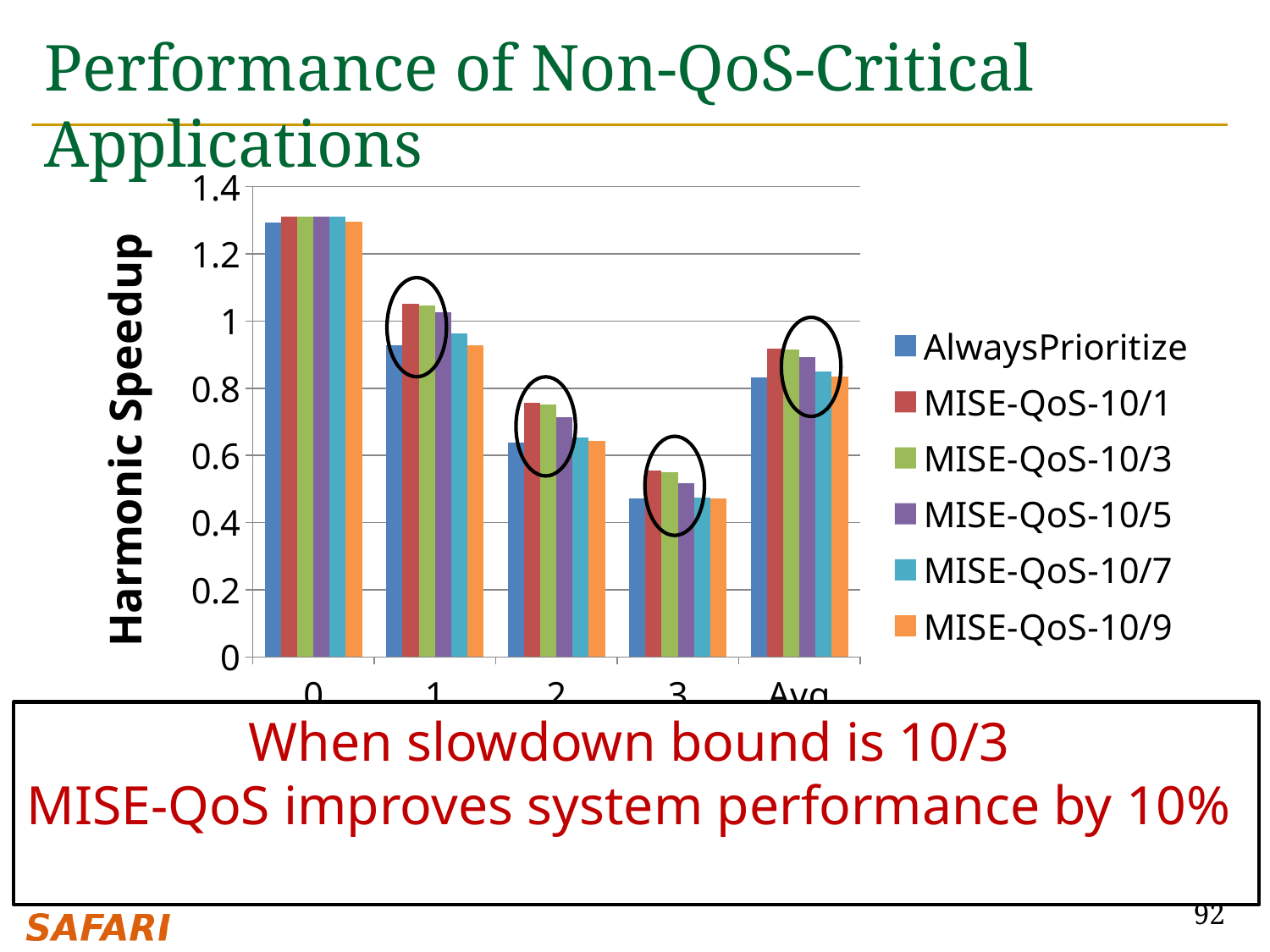
Is the MISE-QoS-10/1 value for category 1 greater or less than 1? greater How many categories are shown along the x axis? 5 Which category has the highest AlwaysPrioritize value? 0 Is the AlwaysPrioritize value for category 0 greater or less than 1.2? greater For category 1, which is larger: the AlwaysPrioritize value or the MISE-QoS-10/1 value? MISE-QoS-10/1 Which series is listed first in the legend? AlwaysPrioritize Is the AlwaysPrioritize value for category 3 greater or less than 0.6? less What is the label of the y axis? Harmonic Speedup Do the AlwaysPrioritize values rise or fall from category 0 to category 3? fall How many series does the legend list? 6 What kind of chart is shown on the slide? bar chart